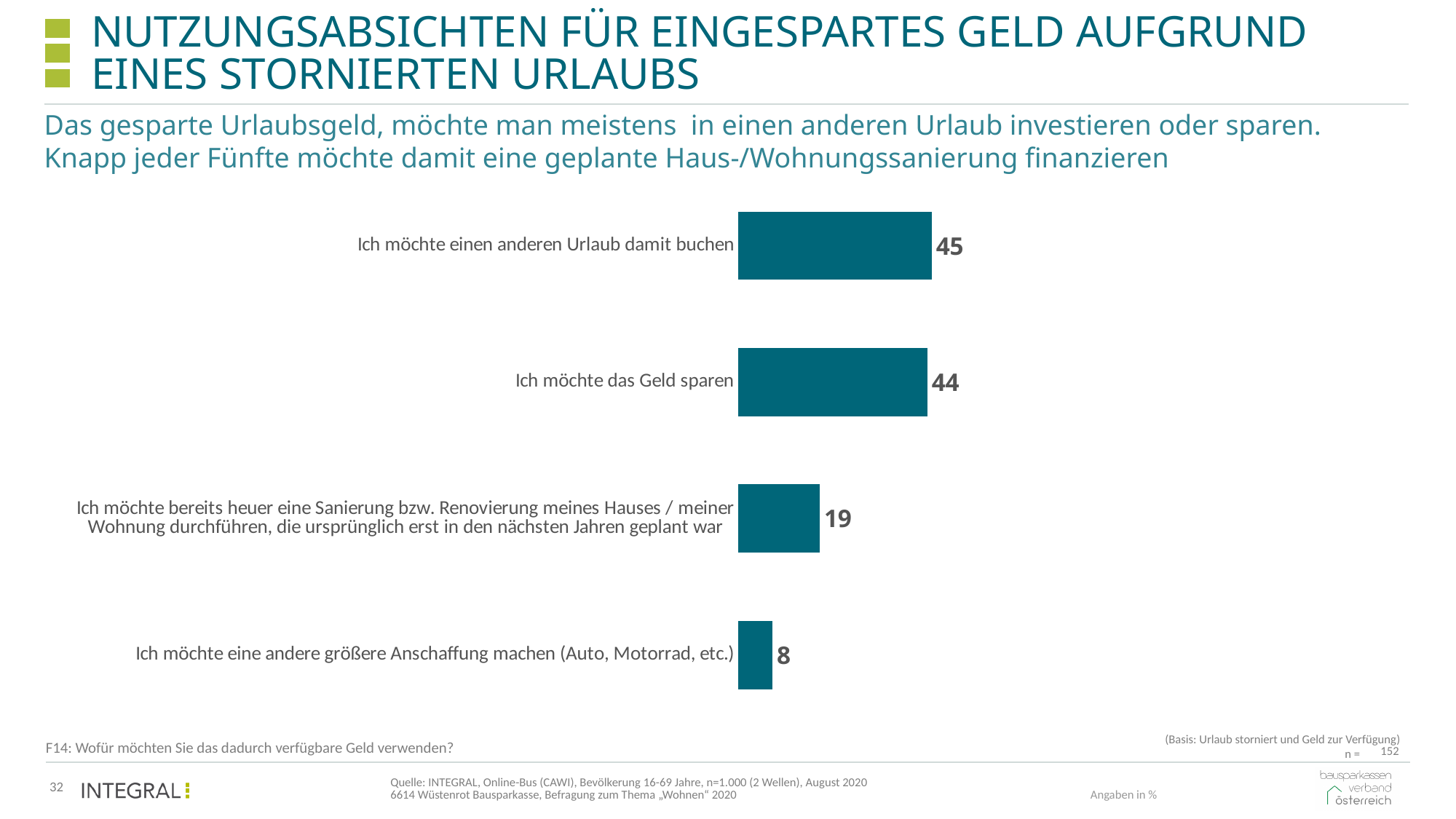
What is the value for "Ich möchte eine andere größere Anschaffung machen (Auto, Motorrad, etc.)"? 8 What is the value for "Ich möchte das Geld sparen"? 44 Which category has the highest value? Ich möchte einen anderen Urlaub damit buchen In what unit are the values given, according to the note at the bottom of the slide? % What is the difference between the value for "Ich möchte einen anderen Urlaub damit buchen" and the value for "Ich möchte das Geld sparen"? 1 What kind of chart is shown on the slide? Bar chart What is the value for the bar about carrying out a renovation of the house/apartment already this year? 19 How many categories are shown in the chart? 4 What is the difference between the value for the renovation category (19) and the value for "Ich möchte eine andere größere Anschaffung machen"? 11 Which category has the lowest value? Ich möchte eine andere größere Anschaffung machen (Auto, Motorrad, etc.) What is the value for "Ich möchte einen anderen Urlaub damit buchen"? 45 Which is larger: the value for "Ich möchte das Geld sparen" or the value for the renovation category? Ich möchte das Geld sparen